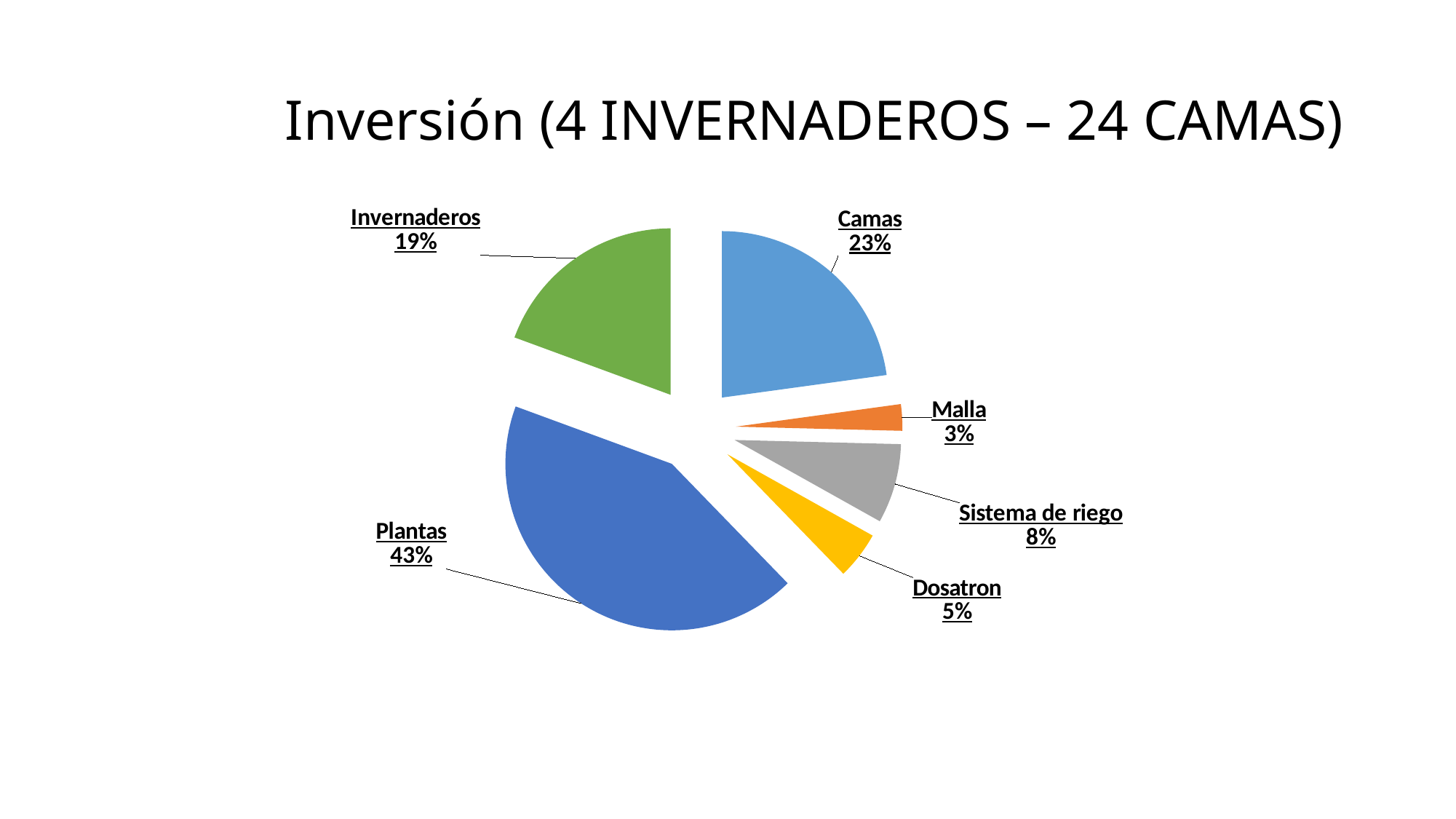
Which category has the smallest share of the pie? Malla What is the difference in percentage points between Camas and Invernaderos? 4 What colour is the Plantas slice? Blue What share of the investment is Camas? 23% What share of the investment is Sistema de riego? 8% What kind of chart is shown on the slide? Pie chart Which is larger, the share for Dosatron or the share for Sistema de riego? Sistema de riego What share of the investment is Plantas? 43% What is the title of the chart? Inversión (4 INVERNADEROS – 24 CAMAS) What share of the investment is Malla? 3% How many categories are shown in the pie chart? 6 Which category has the largest share of the pie? Plantas